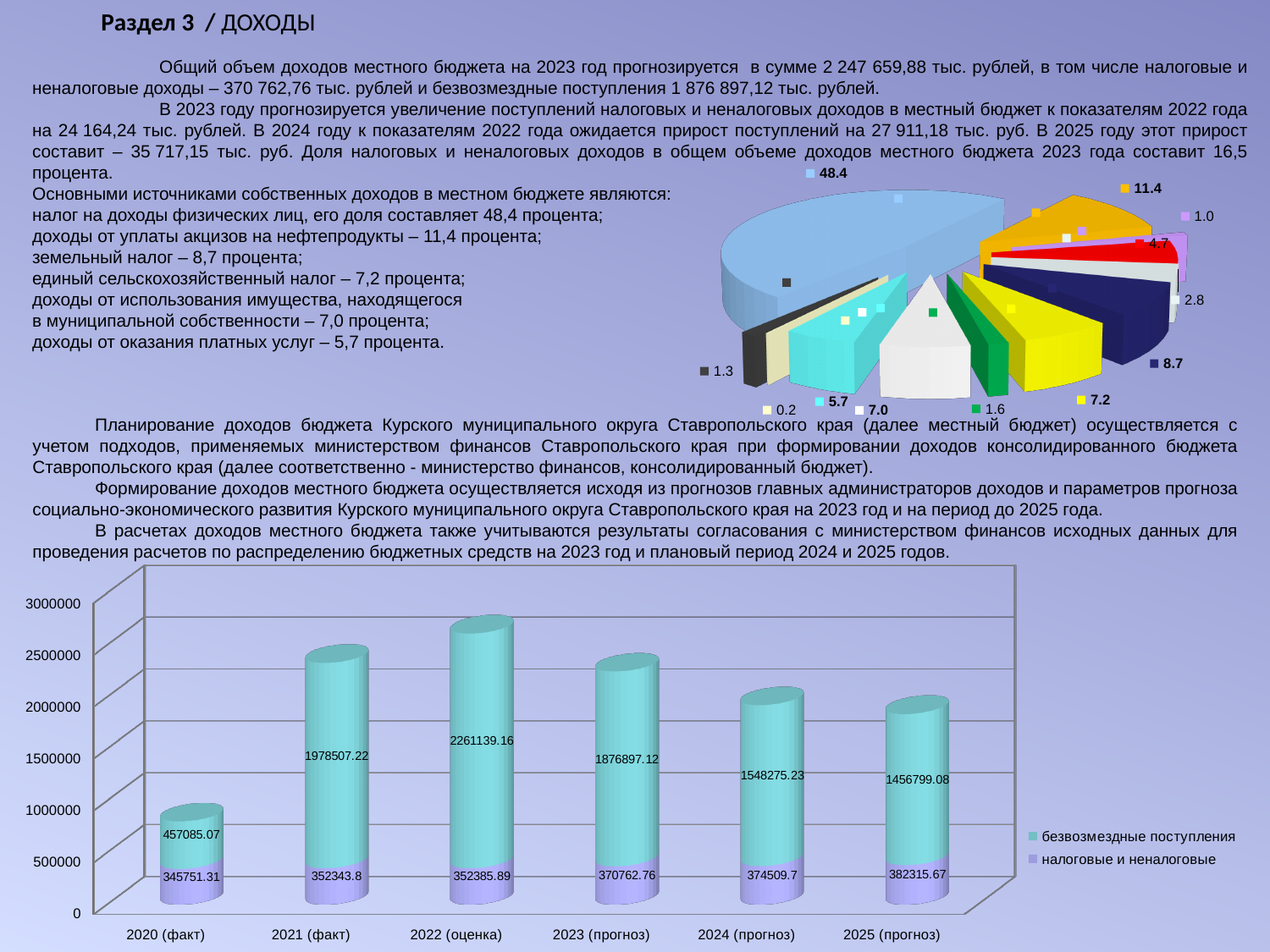
In the bar chart at the bottom of the slide, which year has the highest value of безвозмездные поступления? 2022 (оценка) In the bar chart at the bottom of the slide, which year has the lowest value of безвозмездные поступления? 2020 (факт) In the bar chart at the bottom of the slide, what is the value of безвозмездные поступления for 2022 (оценка)? 2261139.16 In the bar chart at the bottom of the slide, do the values of налоговые и неналоговые rise or fall from 2020 (факт) to 2025 (прогноз)? rise In the bar chart at the bottom of the slide, how many years are shown on the x axis? 6 What kind of chart is shown in the upper right part of the slide? pie chart In the bar chart at the bottom of the slide, what is the difference between безвозмездные поступления in 2022 (оценка) and 2021 (факт)? 282631.94 In the bar chart at the bottom of the slide, what is the total of the stacked bar for 2023 (прогноз)? 2247659.88 In the pie chart in the upper right part of the slide, what is the value of the largest slice? 48.4 In the bar chart at the bottom of the slide, which is larger: налоговые и неналоговые in 2025 (прогноз) or in 2020 (факт)? 2025 (прогноз) In the bar chart at the bottom of the slide, what is the value of налоговые и неналоговые for 2023 (прогноз)? 370762.76 In the bar chart at the bottom of the slide, how many series does the legend list? 2